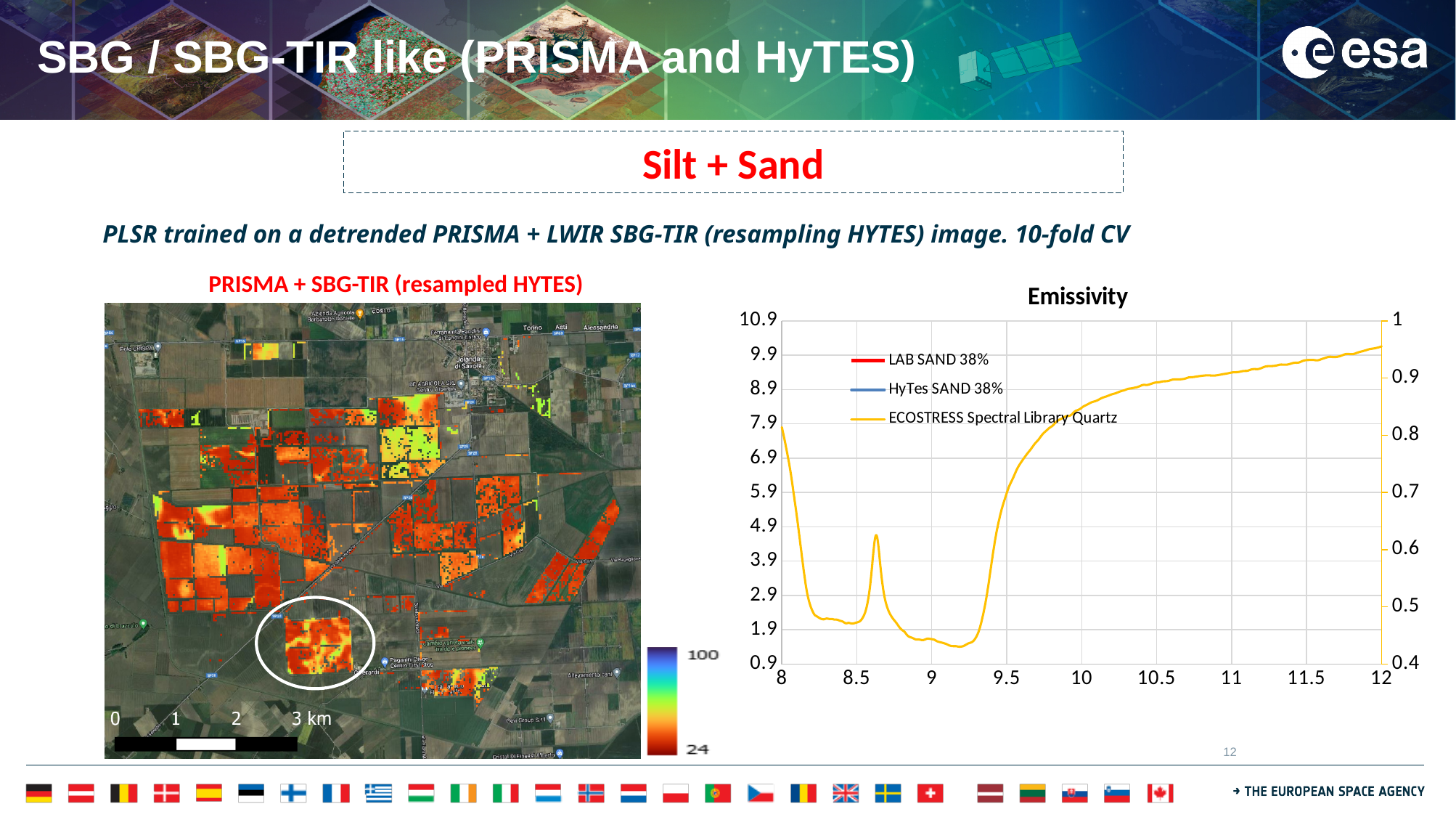
In the Emissivity chart, is the ECOSTRESS Spectral Library Quartz value at x = 12 greater or less than 0.9 on the right-hand axis? greater In the Emissivity chart, is the ECOSTRESS Spectral Library Quartz value at x = 9.2 greater or less than 0.5 on the right-hand axis? less What is the highest tick value shown on the x axis of the Emissivity chart? 12 How many series does the legend of the Emissivity chart list? 3 In the Emissivity chart, is the ECOSTRESS Spectral Library Quartz value higher at x = 11 or at x = 9? x = 11 In the Emissivity chart, which legend entry is drawn in yellow? ECOSTRESS Spectral Library Quartz What is the title of the chart on the right of the slide? Emissivity In the Emissivity chart, does the ECOSTRESS Spectral Library Quartz line rise or fall between x = 8 and x = 8.3? fall In the Emissivity chart, is the ECOSTRESS Spectral Library Quartz value at x = 10 greater or less than 0.8 on the right-hand axis? greater What kind of chart is the Emissivity chart on the right of the slide? line chart In the Emissivity chart, does the ECOSTRESS Spectral Library Quartz line rise or fall between x = 9.5 and x = 12? rise